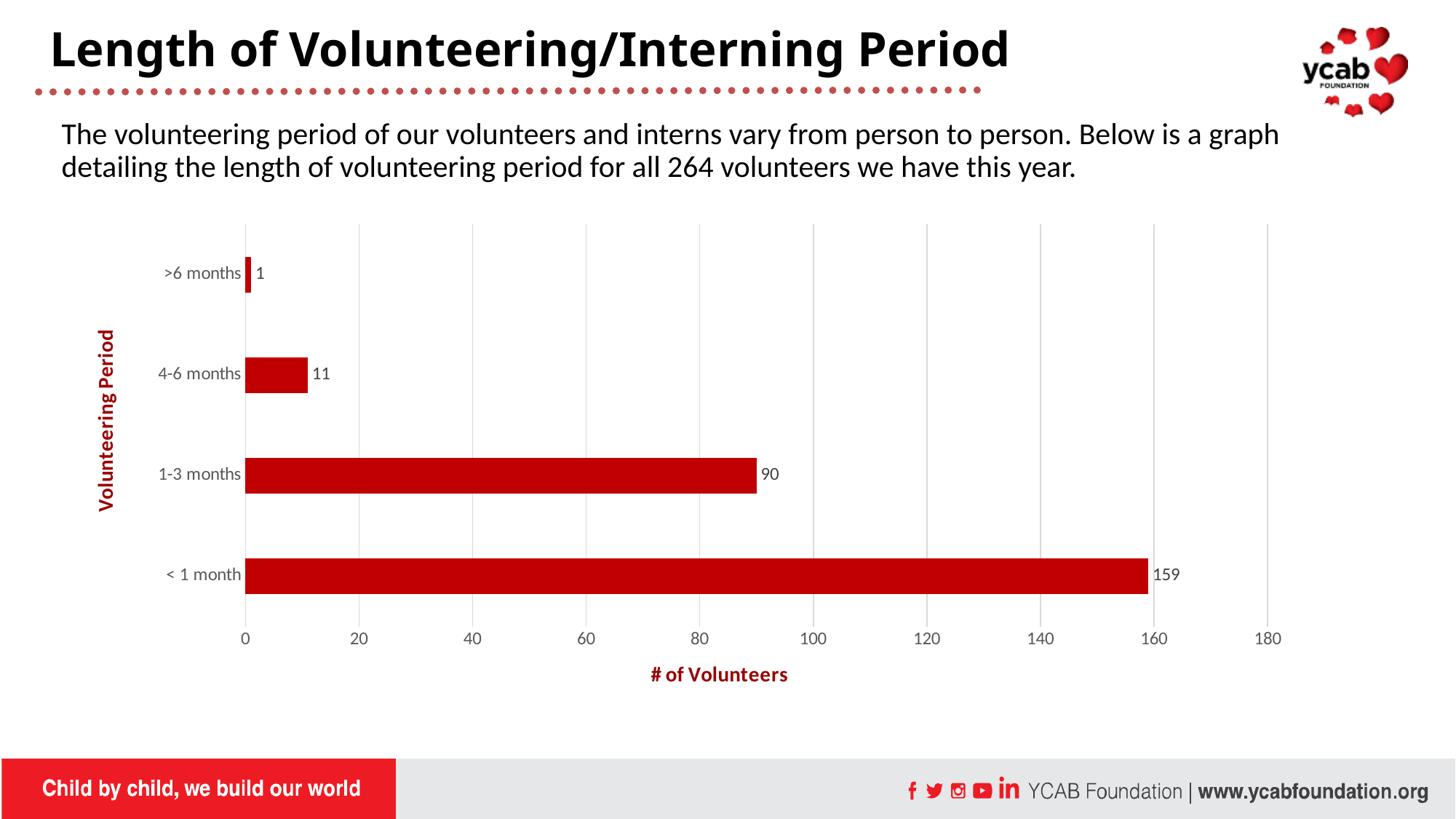
How many volunteering period categories are shown in the chart? 4 What is the label of the horizontal axis of the chart? # of Volunteers What type of chart is shown on the slide? Bar chart What is the number of volunteers for the 1-3 months period? 90 Which has more volunteers, 1-3 months or 4-6 months? 1-3 months What is the difference between the 4-6 months and >6 months values? 10 What is the value for the >6 months category? 1 How many volunteers volunteered for 4-6 months? 11 How many volunteers had a volunteering period of less than 1 month? 159 Which volunteering period has the lowest number of volunteers? >6 months What is the difference in number of volunteers between the < 1 month and 1-3 months periods? 69 Which volunteering period has the highest number of volunteers? < 1 month